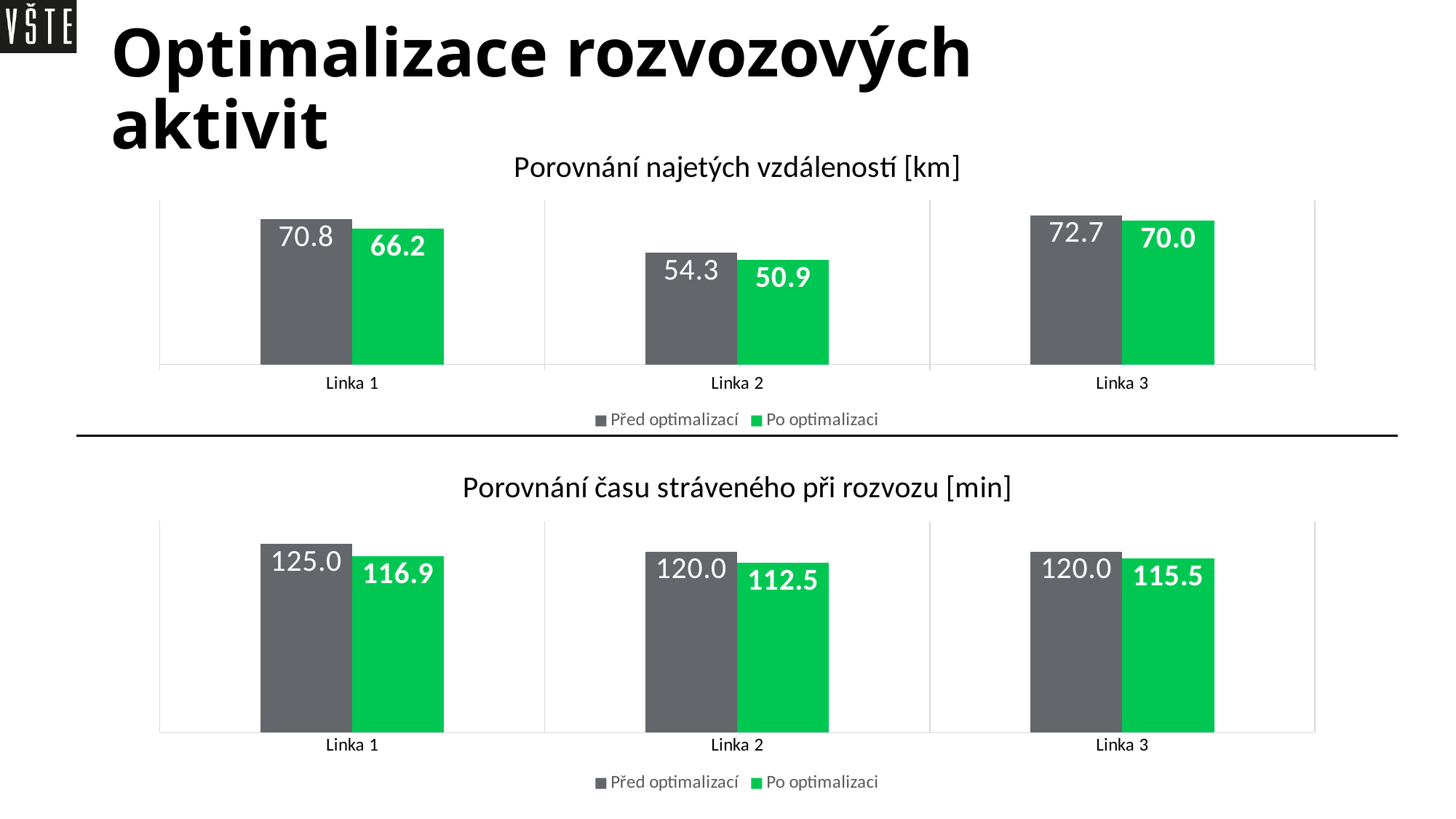
In the chart 'Porovnání času stráveného při rozvozu [min]', what is the value for Linka 1 in the 'Po optimalizaci' series? 116.9 In the chart 'Porovnání najetých vzdáleností [km]', which category has the highest 'Před optimalizací' value? Linka 3 How many categories are shown in the chart 'Porovnání najetých vzdáleností [km]'? 3 In the chart 'Porovnání najetých vzdáleností [km]', which category has the lowest 'Po optimalizaci' value? Linka 2 In the chart 'Porovnání času stráveného při rozvozu [min]', which category has the lowest 'Po optimalizaci' value? Linka 2 In the chart 'Porovnání času stráveného při rozvozu [min]', which is larger for Linka 3: the 'Před optimalizací' value or the 'Po optimalizaci' value? Před optimalizací In the chart 'Porovnání času stráveného při rozvozu [min]', what is the value for Linka 3 in the 'Před optimalizací' series? 120.0 In the chart 'Porovnání najetých vzdáleností [km]', what is the value for Linka 3 in the 'Po optimalizaci' series? 70.0 In the chart 'Porovnání najetých vzdáleností [km]', what is the difference between the 'Před optimalizací' and 'Po optimalizaci' values for Linka 1? 4.6 In the chart 'Porovnání času stráveného při rozvozu [min]', what is the difference between the 'Před optimalizací' and 'Po optimalizaci' values for Linka 2? 7.5 How many series does the legend of the chart 'Porovnání času stráveného při rozvozu [min]' list? 2 In the chart 'Porovnání najetých vzdáleností [km]', what is the value for Linka 2 in the 'Před optimalizací' series? 54.3